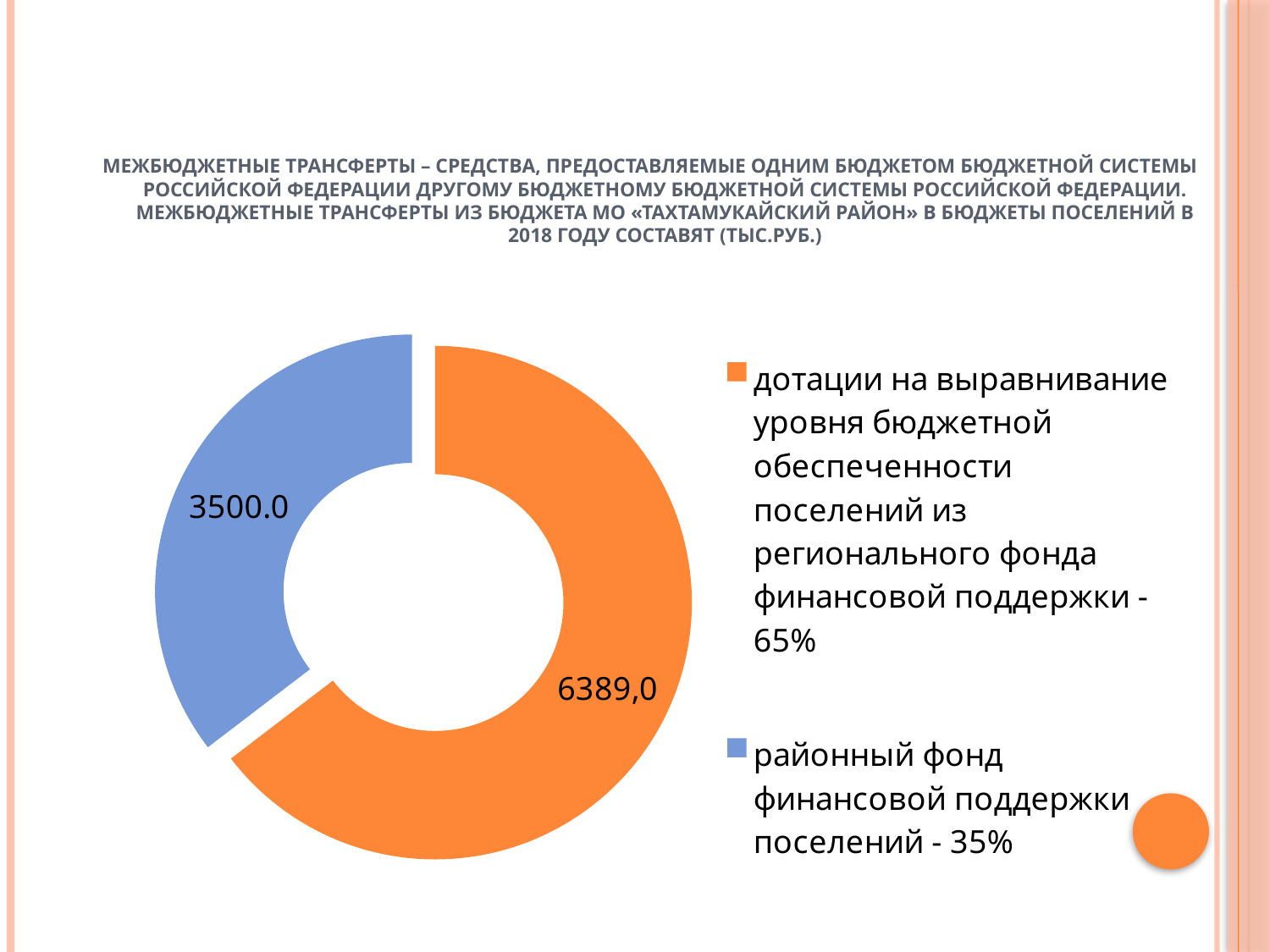
Which category has the smallest slice of the chart? районный фонд финансовой поддержки поселений What share of the chart does дотации на выравнивание уровня бюджетной обеспеченности поселений represent, according to the legend? 65% Which is larger: the value for дотации на выравнивание or the value for районный фонд финансовой поддержки поселений? дотации на выравнивание What is the total of the two values shown on the chart? 9889 What value is shown for the blue slice (районный фонд финансовой поддержки поселений)? 3500.0 How many categories does the chart show? 2 What colour is the slice for районный фонд финансовой поддержки поселений? blue What share of the chart does районный фонд финансовой поддержки поселений represent, according to the legend? 35% Which category has the largest slice of the chart? дотации на выравнивание уровня бюджетной обеспеченности поселений из регионального фонда финансовой поддержки What kind of chart is shown on the slide? doughnut chart What is the difference between the value for дотации на выравнивание (6389,0) and the value for районный фонд финансовой поддержки поселений (3500.0)? 2889 What value is shown for the orange slice (дотации на выравнивание уровня бюджетной обеспеченности поселений из регионального фонда финансовой поддержки)? 6389,0